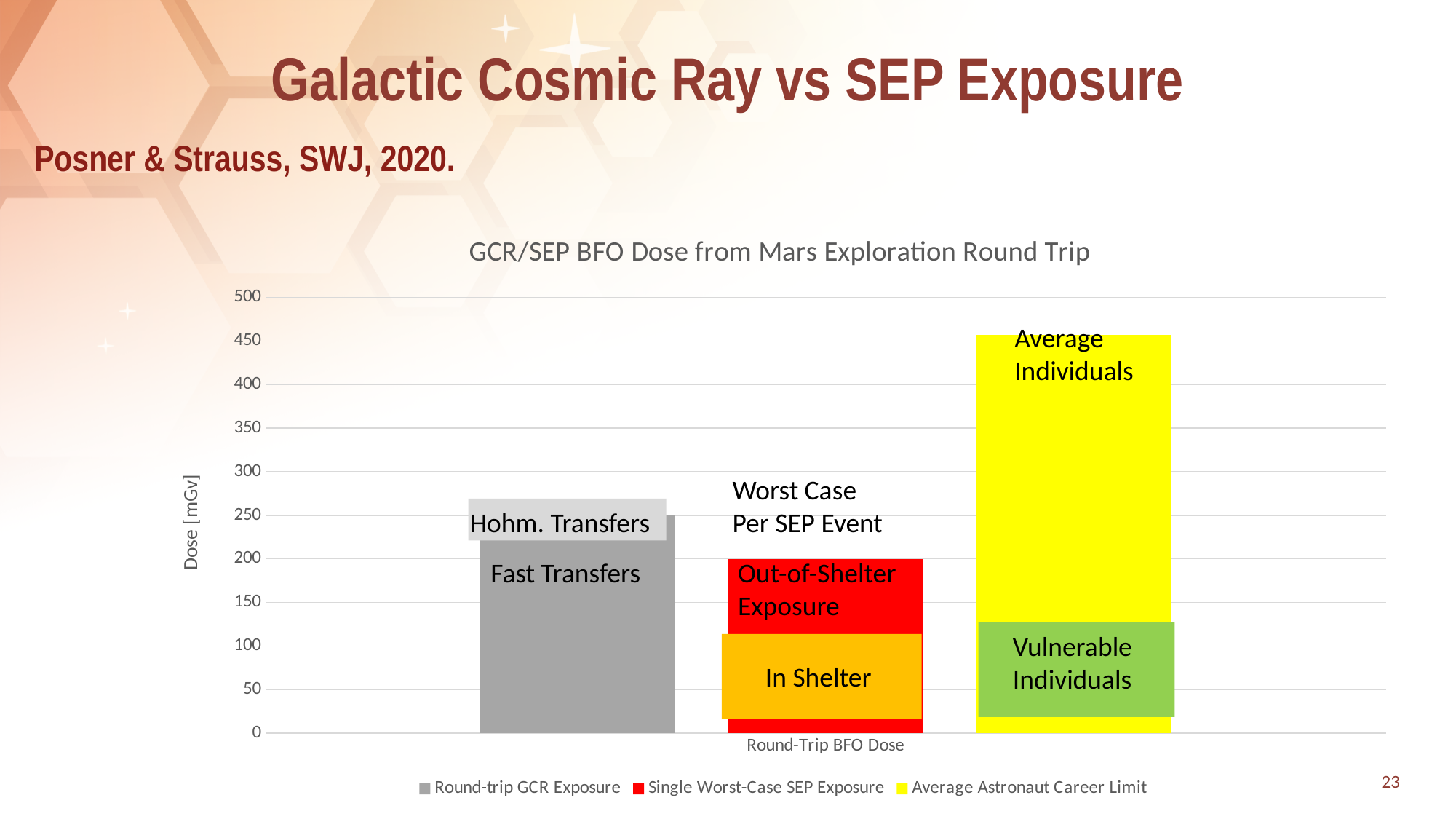
What kind of chart is shown on the slide? bar chart Which is larger, the Round-trip GCR Exposure bar or the Single Worst-Case SEP Exposure bar? Round-trip GCR Exposure What is the label on the vertical axis of the chart? Dose [mGv] What is the difference between the Round-trip GCR Exposure bar and the Single Worst-Case SEP Exposure bar? 50 What is the value of the Single Worst-Case SEP Exposure bar? 200 How many bars are plotted in the chart? 3 What is the title of the chart? GCR/SEP BFO Dose from Mars Exploration Round Trip What is the value of the Round-trip GCR Exposure bar? 250 Which series has the highest bar in the chart? Average Astronaut Career Limit Which series has the lowest bar in the chart? Single Worst-Case SEP Exposure Is the value for Average Astronaut Career Limit greater or less than 400? greater How many series does the chart legend list? 3